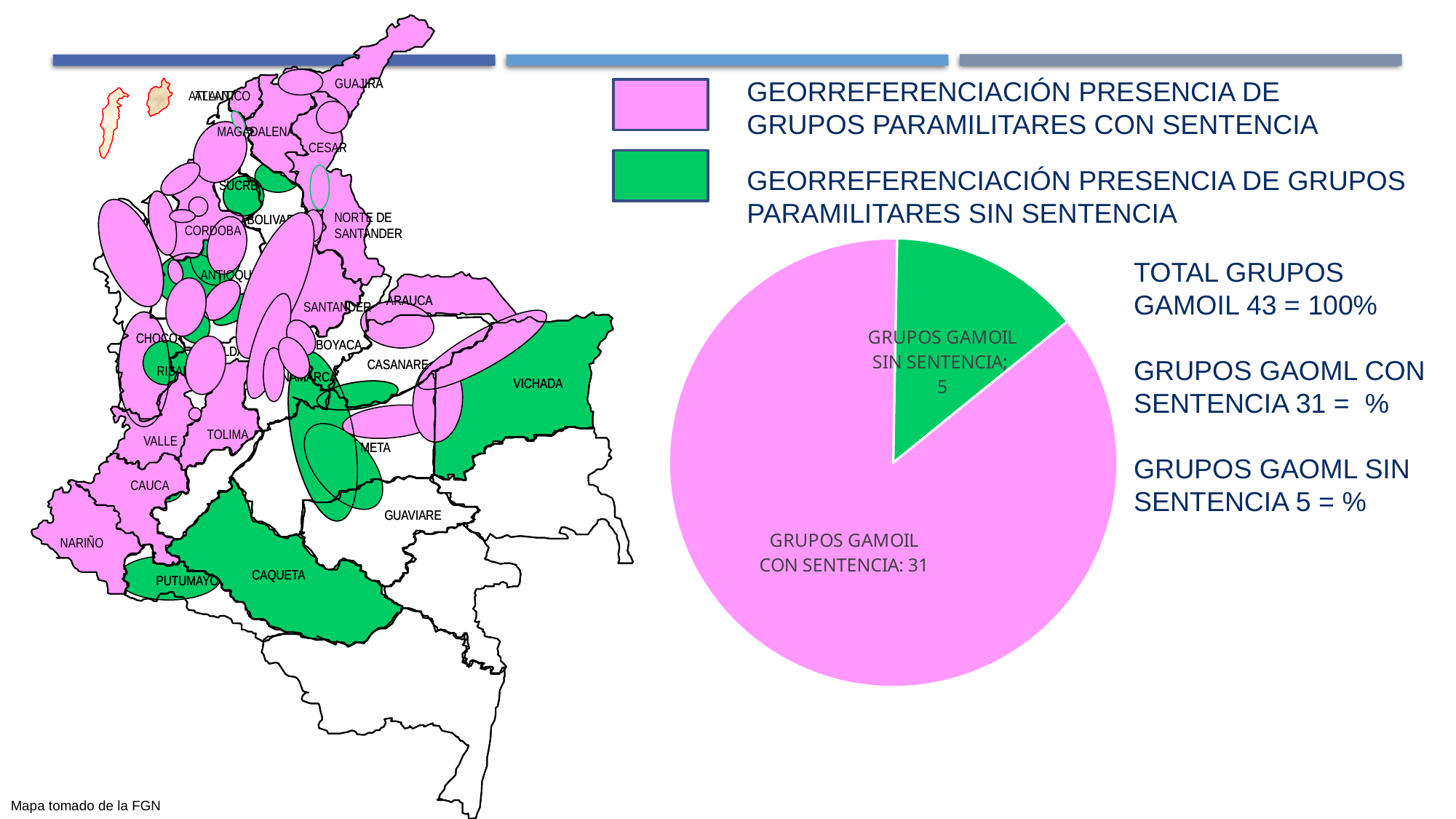
What kind of chart is shown on the right side of the slide? Pie chart Which slice of the pie chart is the smallest? GRUPOS GAMOIL SIN SENTENCIA What is the difference between the values for GRUPOS GAMOIL CON SENTENCIA and GRUPOS GAMOIL SIN SENTENCIA in the pie chart? 26 In the pie chart, which is larger: GRUPOS GAMOIL CON SENTENCIA or GRUPOS GAMOIL SIN SENTENCIA? GRUPOS GAMOIL CON SENTENCIA In the pie chart, what is the value for GRUPOS GAMOIL SIN SENTENCIA? 5 What colour is the GRUPOS GAMOIL CON SENTENCIA slice in the pie chart? Pink What colour is the GRUPOS GAMOIL SIN SENTENCIA slice in the pie chart? Green How many slices does the pie chart have? 2 In the pie chart, what is the value for GRUPOS GAMOIL CON SENTENCIA? 31 Which slice of the pie chart is the largest? GRUPOS GAMOIL CON SENTENCIA